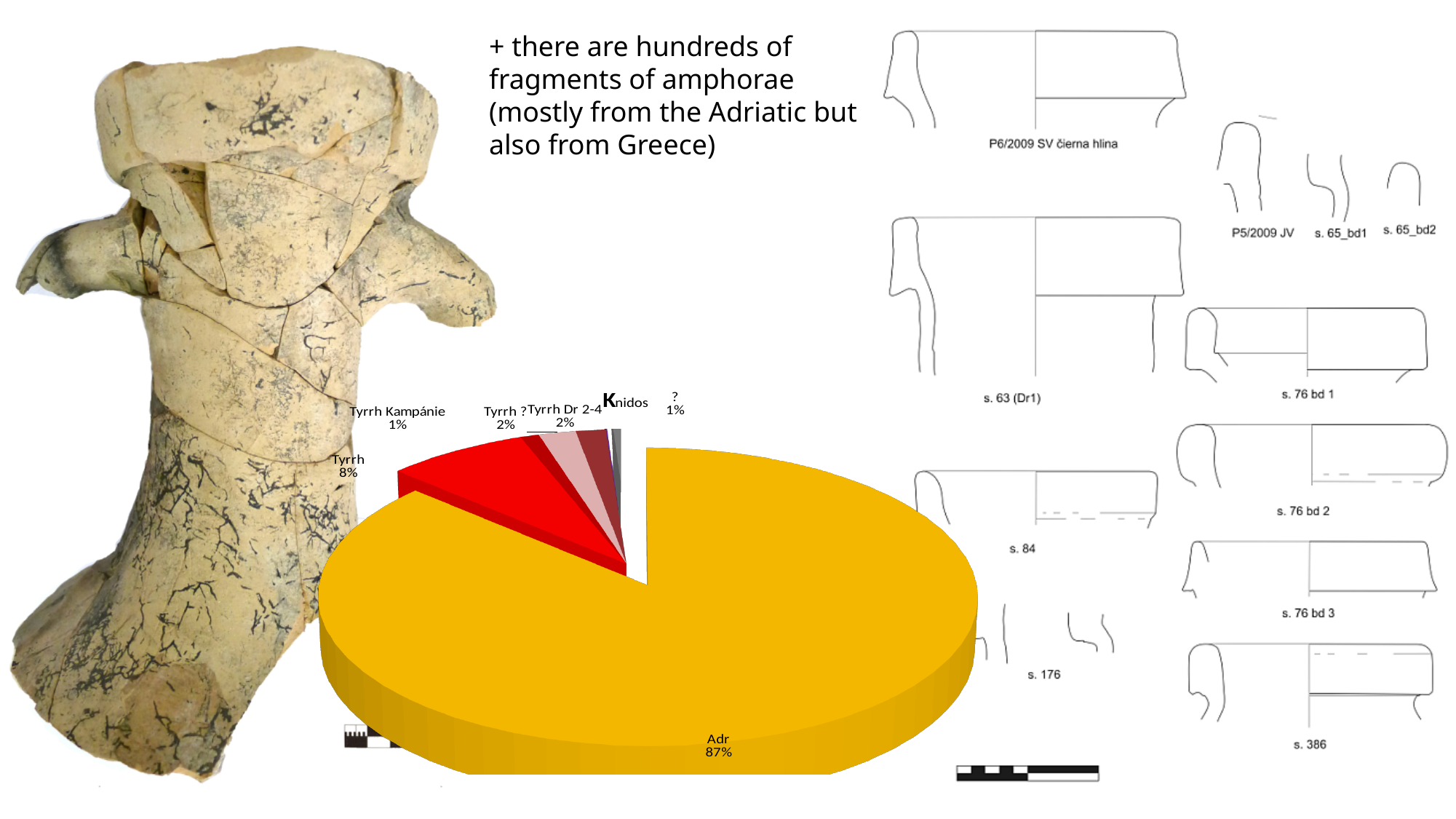
What kind of chart is shown on the slide? pie chart What percentage is shown for the slice labelled '?'? 1% Is the share for Adr greater or less than 50%? greater How many slices (categories) are labelled on the pie chart? 7 What percentage is shown for Tyrrh Kampánie? 1% Which category has the largest slice of the pie? Adr What is the difference in percentage points between the Adr slice and the Tyrrh slice? 79 What percentage is shown for Tyrrh Dr 2-4? 2% What percentage is shown for the Tyrrh slice? 8% What colour is the Adr slice of the pie chart? yellow Which is larger, the Tyrrh slice or the Tyrrh Dr 2-4 slice? Tyrrh What share of the pie does the Adr slice represent? 87%